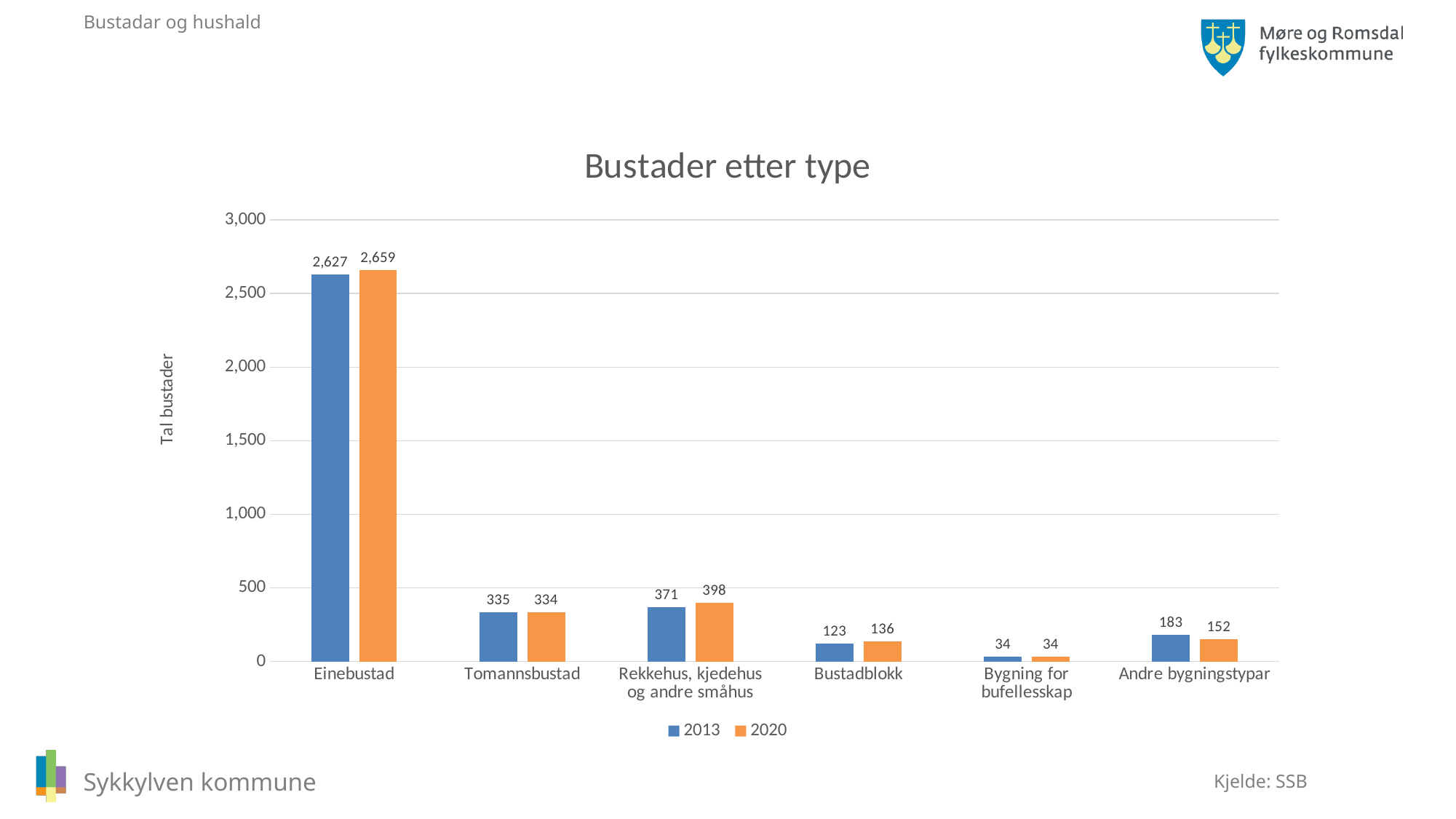
What is the value for Bustadblokk in 2013? 123 Which category has the highest value in 2013? Einebustad What is the difference between the 2020 and 2013 values for Einebustad? 32 Which is larger for Rekkehus, kjedehus og andre småhus: the 2013 value or the 2020 value? 2020 What is the value for Einebustad in 2020? 2,659 How many categories are shown on the x axis? 6 Which category has the lowest value in 2020? Bygning for bufellesskap How many series does the legend list? 2 What is the value for Andre bygningstypar in 2020? 152 Is the value for Tomannsbustad in 2013 greater or less than 500? less What kind of chart is shown on the slide? bar chart What is the difference between the 2013 and 2020 values for Andre bygningstypar? 31